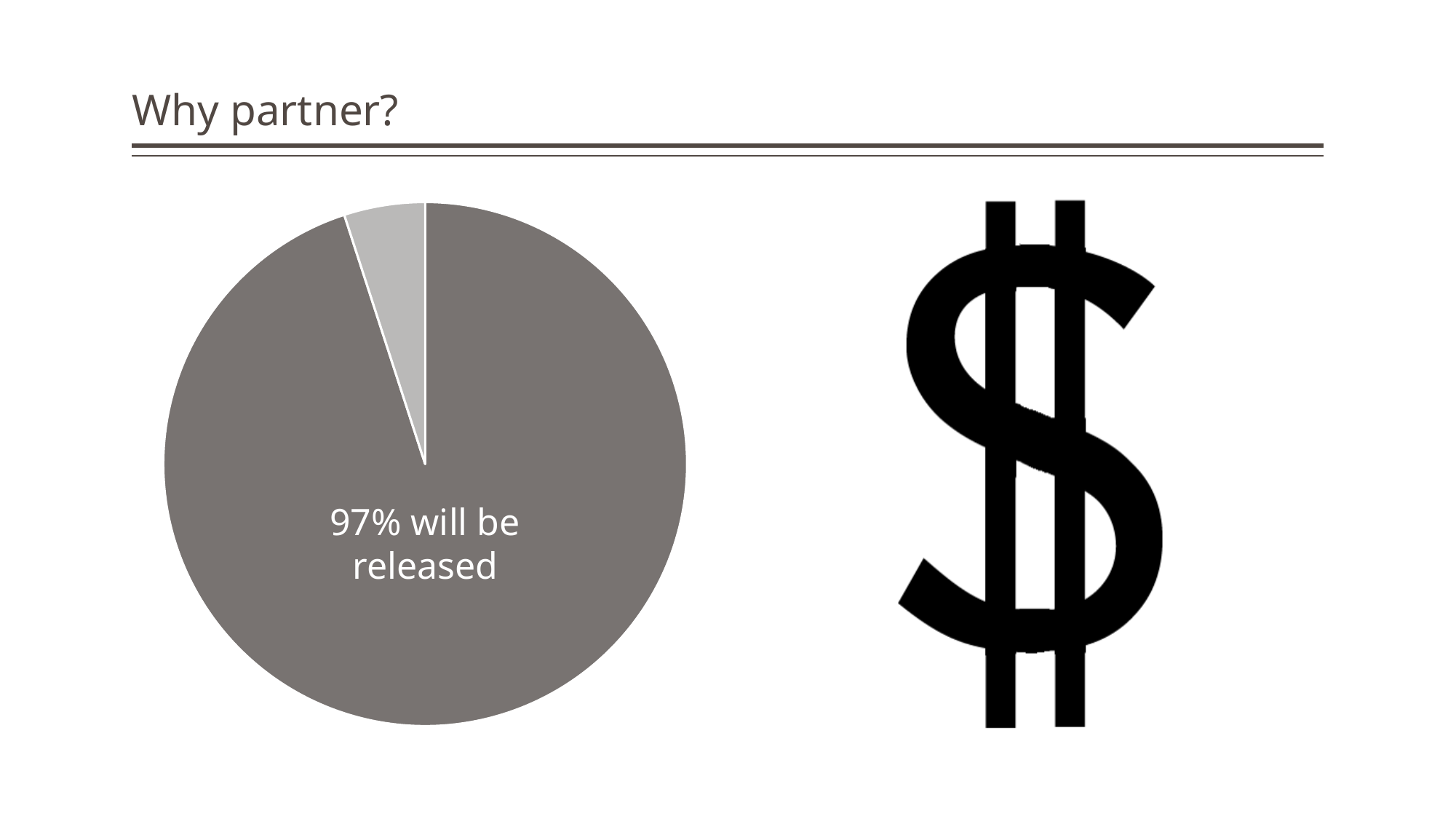
What text label is printed inside the pie chart? 97% will be released How many slices does the pie chart have? 2 Which slice of the pie chart is the largest? 97% will be released Is the share of the large dark slice greater or less than 50%? greater What is the title of the slide containing the pie chart? Why partner? What percentage is printed on the large slice of the pie chart? 97% Which slice is larger, the dark grey slice or the light grey slice? the dark grey slice Is the share of the small light slice greater or less than 10%? less What share of the pie does the slice labelled 'will be released' represent? 97% What kind of chart is shown on the slide? pie chart